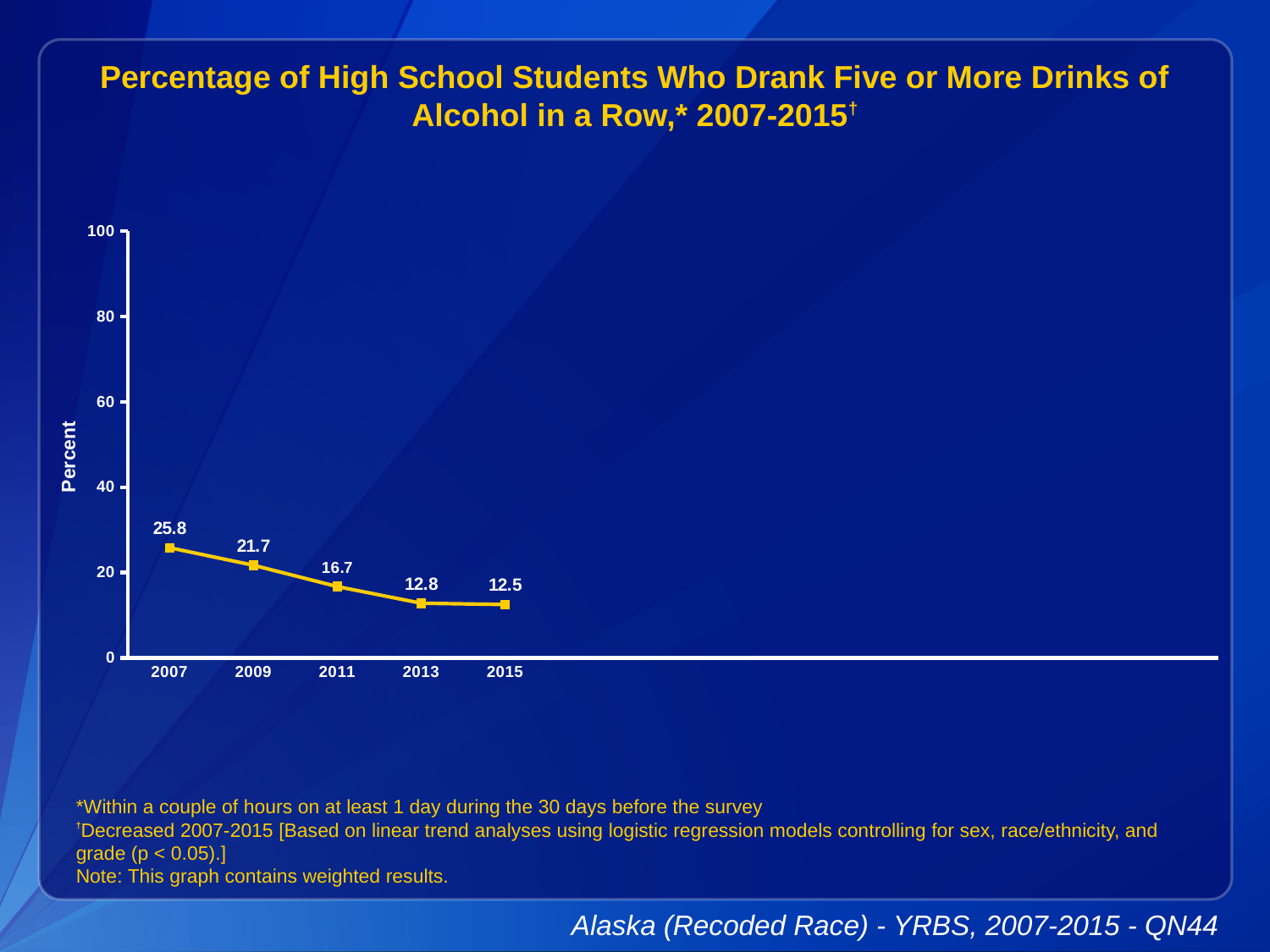
Which is larger, the value for 2009 or the value for 2013? 2009 What is the difference between the 2007 value and the 2015 value? 13.3 What value is shown for 2015? 12.5 How many years are plotted on the chart? 5 What kind of chart is shown on the slide? line chart Is the value for 2007 greater or less than 20? greater Do the values rise or fall from 2007 to 2015? fall What value is shown for 2011? 16.7 Which year has the highest value on the chart? 2007 Which year has the lowest value on the chart? 2015 What is the difference between the 2009 value and the 2011 value? 5 What was the percentage of high school students who drank five or more drinks of alcohol in a row in 2007? 25.8